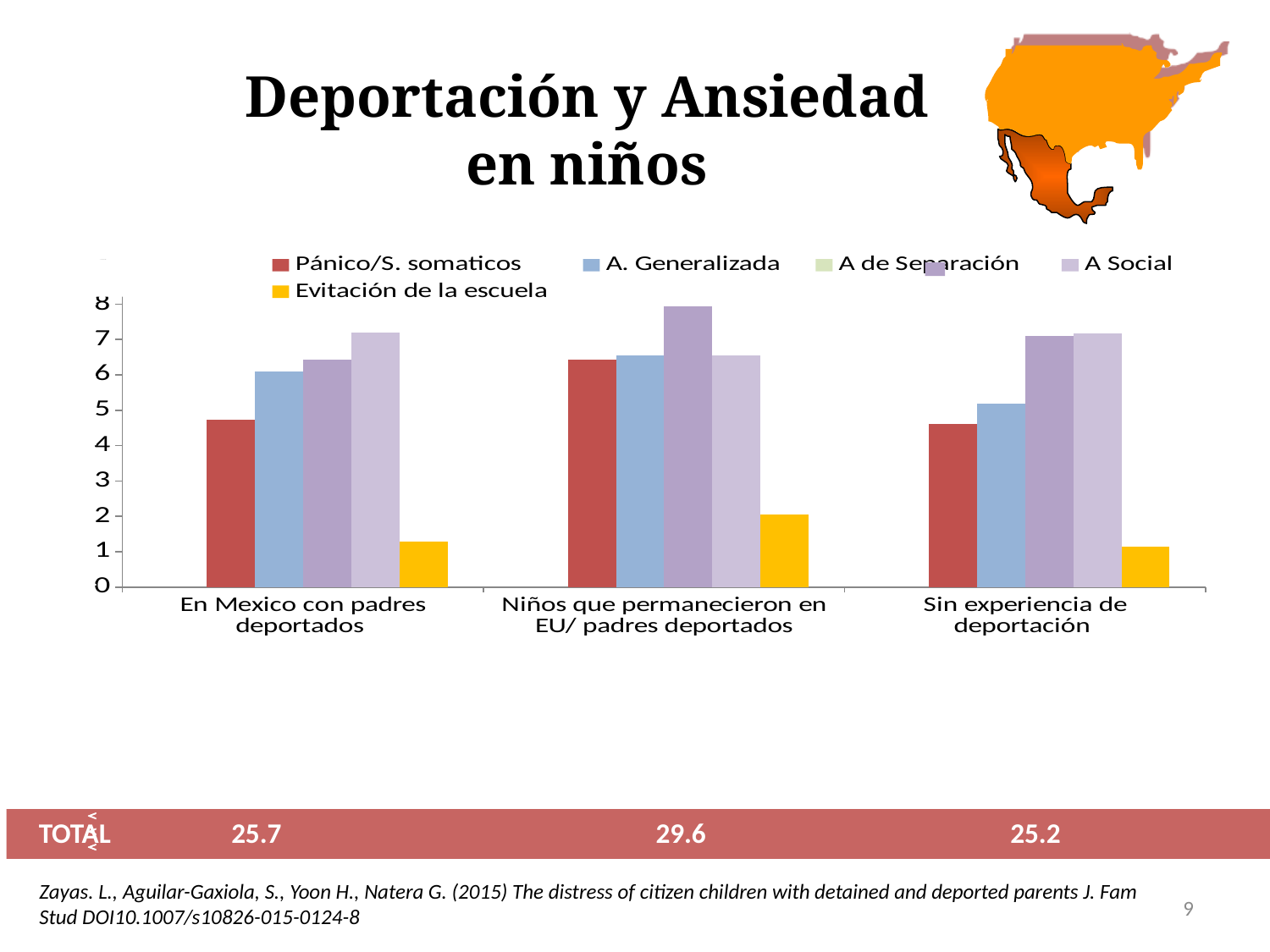
Within the 'En Mexico con padres deportados' group, which series has the lowest bar? Evitación de la escuela Is the value for Pánico/S. somaticos in 'Niños que permanecieron en EU/ padres deportados' greater or less than 6? greater Which series is represented by the yellow bars in the chart? Evitación de la escuela How many categories are shown on the x axis of the chart? 3 Which is larger: Pánico/S. somaticos in 'En Mexico con padres deportados' or Pánico/S. somaticos in 'Niños que permanecieron en EU/ padres deportados'? Niños que permanecieron en EU/ padres deportados What TOTAL value is printed below the chart for the 'Niños que permanecieron en EU/ padres deportados' group? 29.6 Is the value for Evitación de la escuela in 'Sin experiencia de deportación' greater or less than 2? less Within the 'Niños que permanecieron en EU/ padres deportados' group, which series has the highest bar? A de Separación How many series does the chart legend list? 5 What kind of chart is shown on the slide? bar chart Is the value for Pánico/S. somaticos in 'En Mexico con padres deportados' greater or less than 5? less